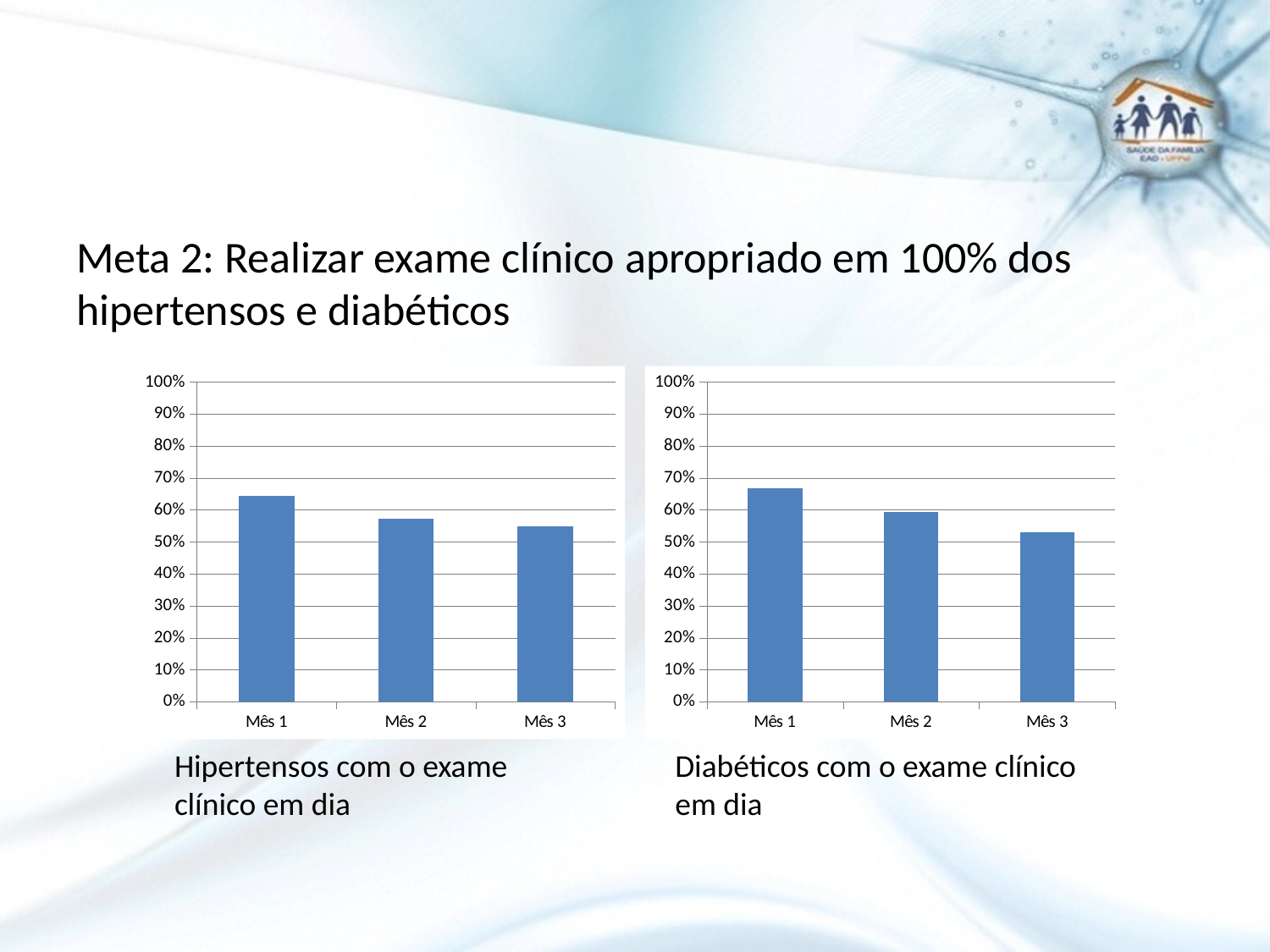
In the right chart, 'Diabéticos com o exame clínico em dia', which month has the lowest value? Mês 3 In the left chart, 'Hipertensos com o exame clínico em dia', is the value for Mês 1 greater or less than 60%? greater In the right chart, 'Diabéticos com o exame clínico em dia', is the value for Mês 3 greater or less than 60%? less In the left chart, 'Hipertensos com o exame clínico em dia', do the values rise or fall from Mês 1 to Mês 3? fall What is the caption below the right chart? Diabéticos com o exame clínico em dia In the right chart, 'Diabéticos com o exame clínico em dia', is the value for Mês 1 greater or less than 70%? less In the right chart, 'Diabéticos com o exame clínico em dia', do the values rise or fall from Mês 1 to Mês 3? fall How many categories are shown on the x axis of the right chart, 'Diabéticos com o exame clínico em dia'? 3 In the left chart, 'Hipertensos com o exame clínico em dia', which is larger, the value for Mês 1 or the value for Mês 3? Mês 1 What kind of chart is the left chart, 'Hipertensos com o exame clínico em dia'? bar chart In the left chart, 'Hipertensos com o exame clínico em dia', which month has the highest value? Mês 1 In the right chart, 'Diabéticos com o exame clínico em dia', which is larger, the value for Mês 1 or the value for Mês 2? Mês 1